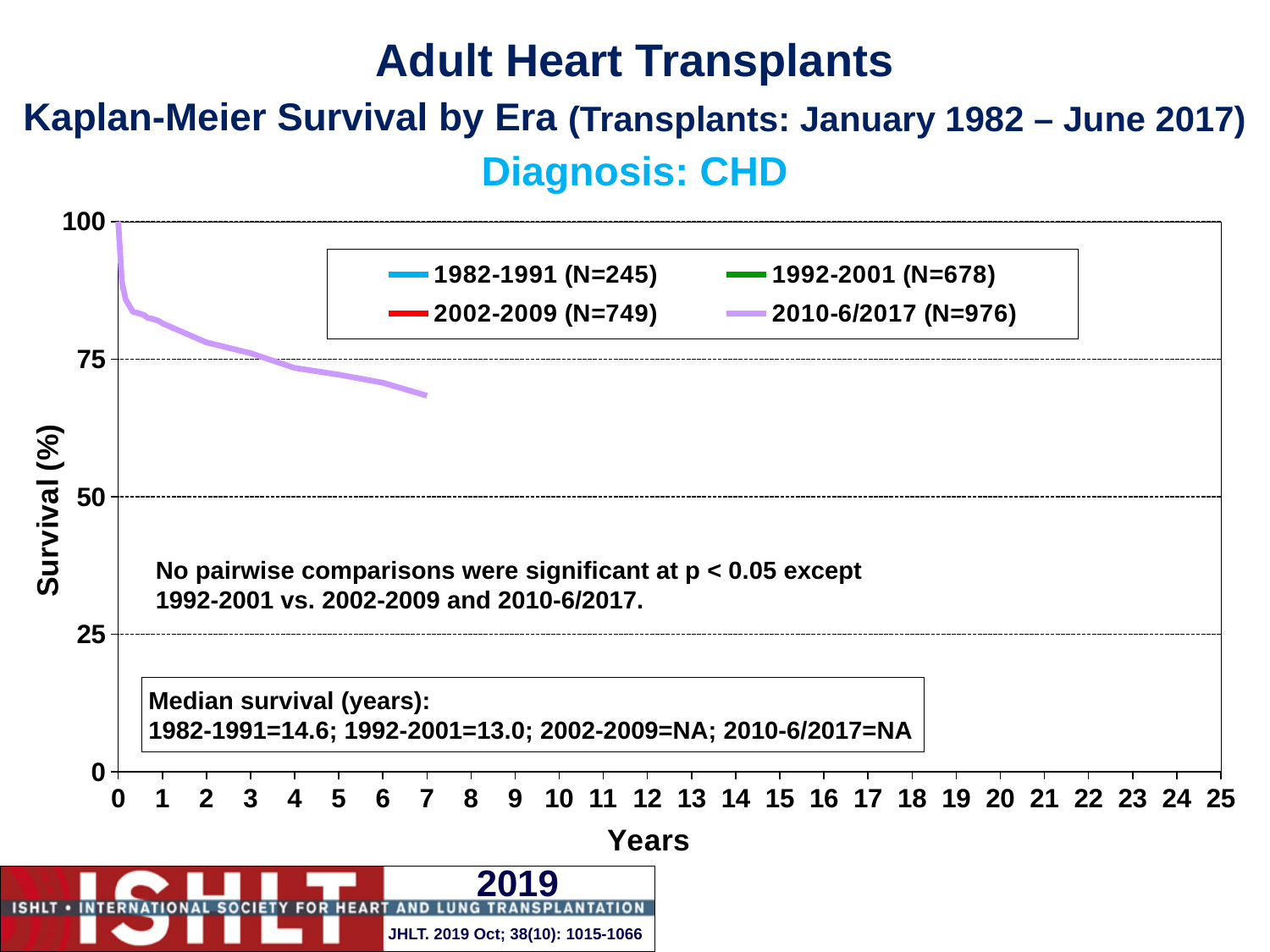
What median survival in years is given for the 1982-1991 era? 14.6 Is the survival value for the 2010-6/2017 curve at 1 year greater or less than 75? greater Does the plotted survival curve for 2010-6/2017 rise or fall as years increase? fall Is the survival value for the 2010-6/2017 curve at 7 years greater or less than 75? less What kind of chart is shown on the slide? line chart What is the label of the y axis? Survival (%) What diagnosis is stated in the chart title? CHD What is the N shown in the legend for the 2010-6/2017 era? 976 How many series does the legend list? 4 What is the N shown in the legend for the 2002-2009 era? 749 Is the survival value for the 2010-6/2017 curve at 5 years greater or less than 50? greater What median survival in years is given for the 1992-2001 era? 13.0